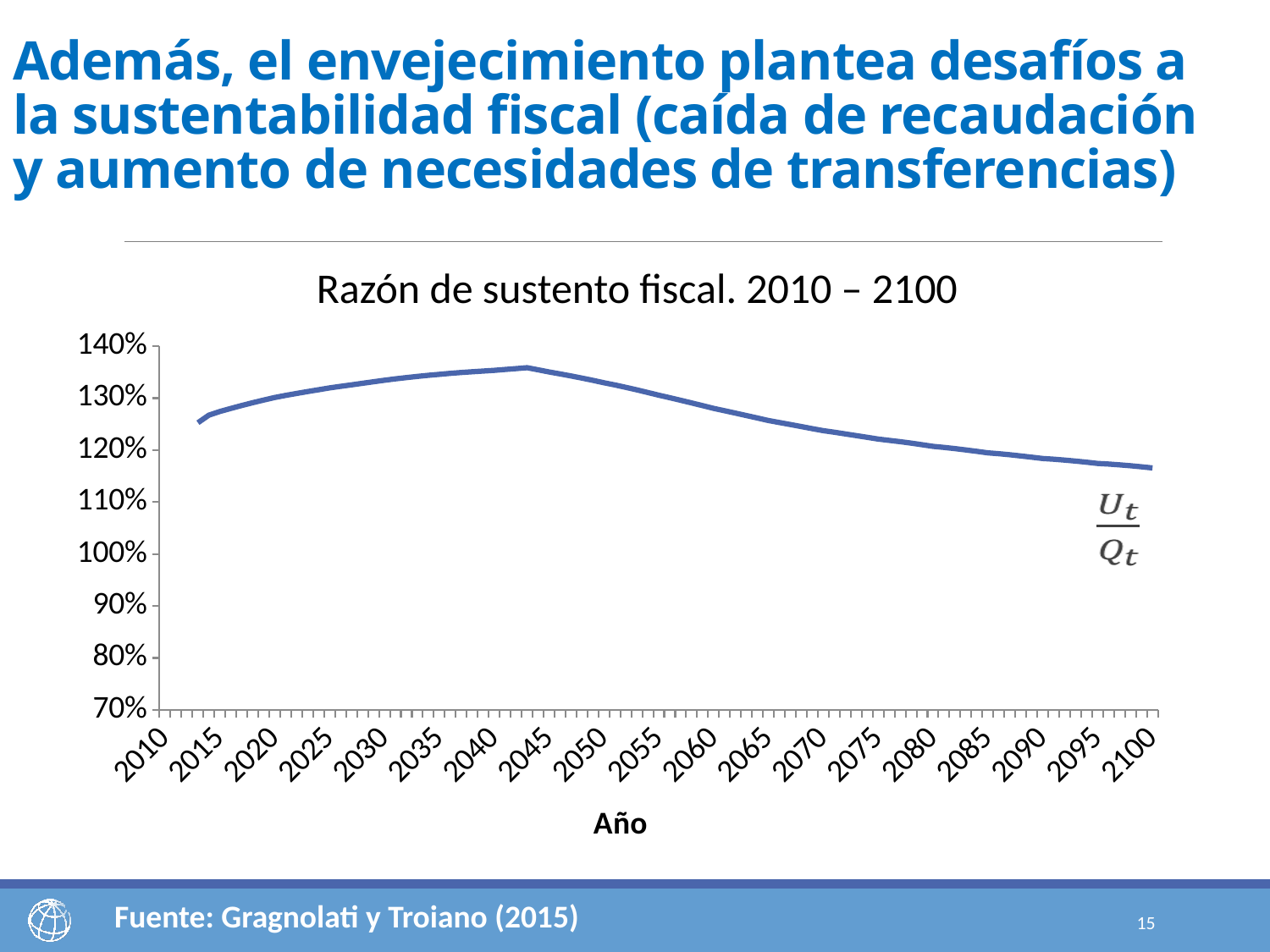
What is the label of the x axis? Año Is the value for 2015 greater or less than 120%? greater Is the value for 2100 greater or less than 120%? less What is the title of the chart? Razón de sustento fiscal. 2010 – 2100 Does the line rise or fall between 2045 and 2100? fall Which is larger, the value for 2045 or the value for 2100? 2045 Is the value for 2060 greater or less than 120%? greater What kind of chart is shown on the slide? Line chart How many year labels are shown on the x axis? 19 Which is larger, the value for 2015 or the value for 2100? 2015